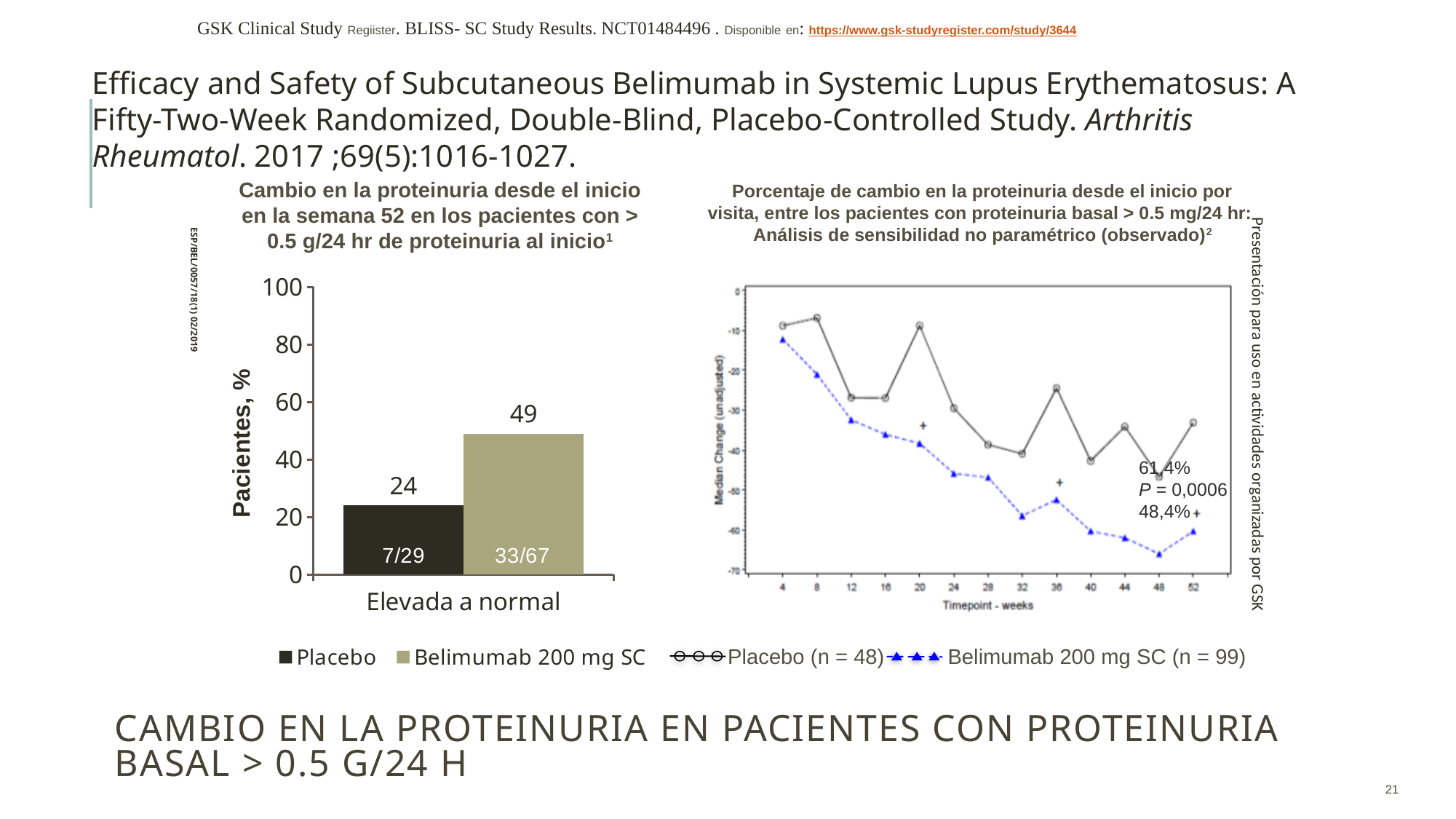
In the right line chart, what is the n value given in the legend for Belimumab 200 mg SC? n = 99 In the left bar chart, what fraction is printed inside the Placebo bar? 7/29 In the left bar chart, which group has the higher value, Placebo or Belimumab 200 mg SC? Belimumab 200 mg SC In the left bar chart, what percentage of patients is shown for Belimumab 200 mg SC? 49 In the right line chart, how many timepoints (weeks) are shown on the x axis? 13 In the left bar chart, what percentage of patients is shown for Placebo? 24 What kind of chart is the chart on the left of the slide? Bar chart What kind of chart is the chart on the right of the slide? Line chart In the right line chart, do the Belimumab 200 mg SC values generally rise or fall from week 4 to week 52? Fall In the left bar chart, what is the difference between the Belimumab 200 mg SC value and the Placebo value? 25 How many series does the legend of the left bar chart list? 2 In the left bar chart, what fraction is printed inside the Belimumab 200 mg SC bar? 33/67